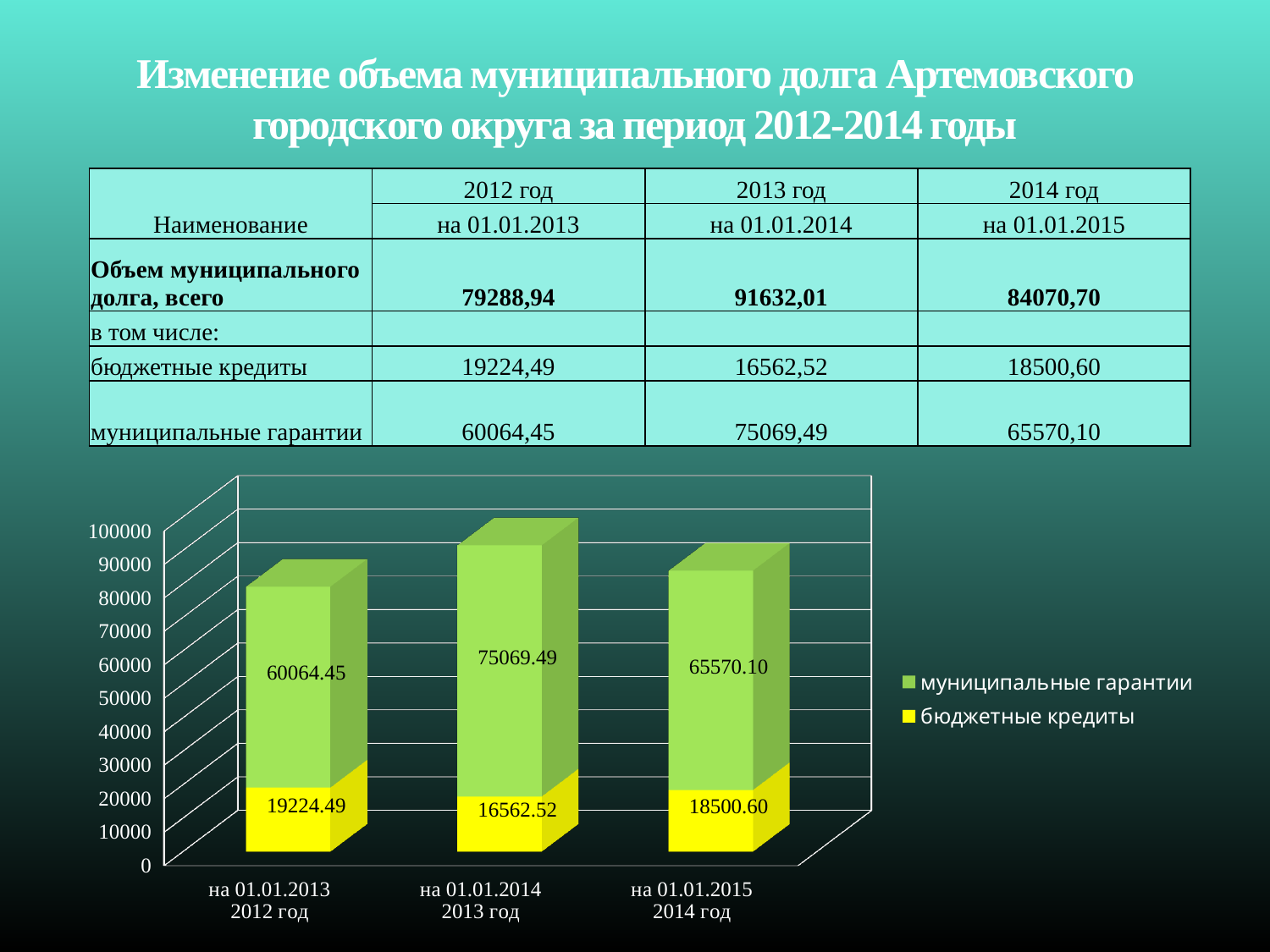
What is the value of муниципальные гарантии for на 01.01.2014 (2013 год)? 75069.49 In which category is бюджетные кредиты lowest? на 01.01.2014 (2013 год) What kind of chart is shown on the slide? stacked bar chart Which colour represents бюджетные кредиты in the chart? yellow How many series does the chart legend list? 2 How many categories are plotted along the x axis of the chart? 3 What is the total of the stacked bar for на 01.01.2014 (2013 год)? 91632.01 What is the difference between муниципальные гарантии for на 01.01.2014 and for на 01.01.2013? 15005.04 Which is larger: бюджетные кредиты for на 01.01.2013 or for на 01.01.2015? на 01.01.2013 What is the value of бюджетные кредиты for на 01.01.2013 (2012 год)? 19224.49 In which category is муниципальные гарантии highest? на 01.01.2014 (2013 год) What is the value of бюджетные кредиты for на 01.01.2015 (2014 год)? 18500.60